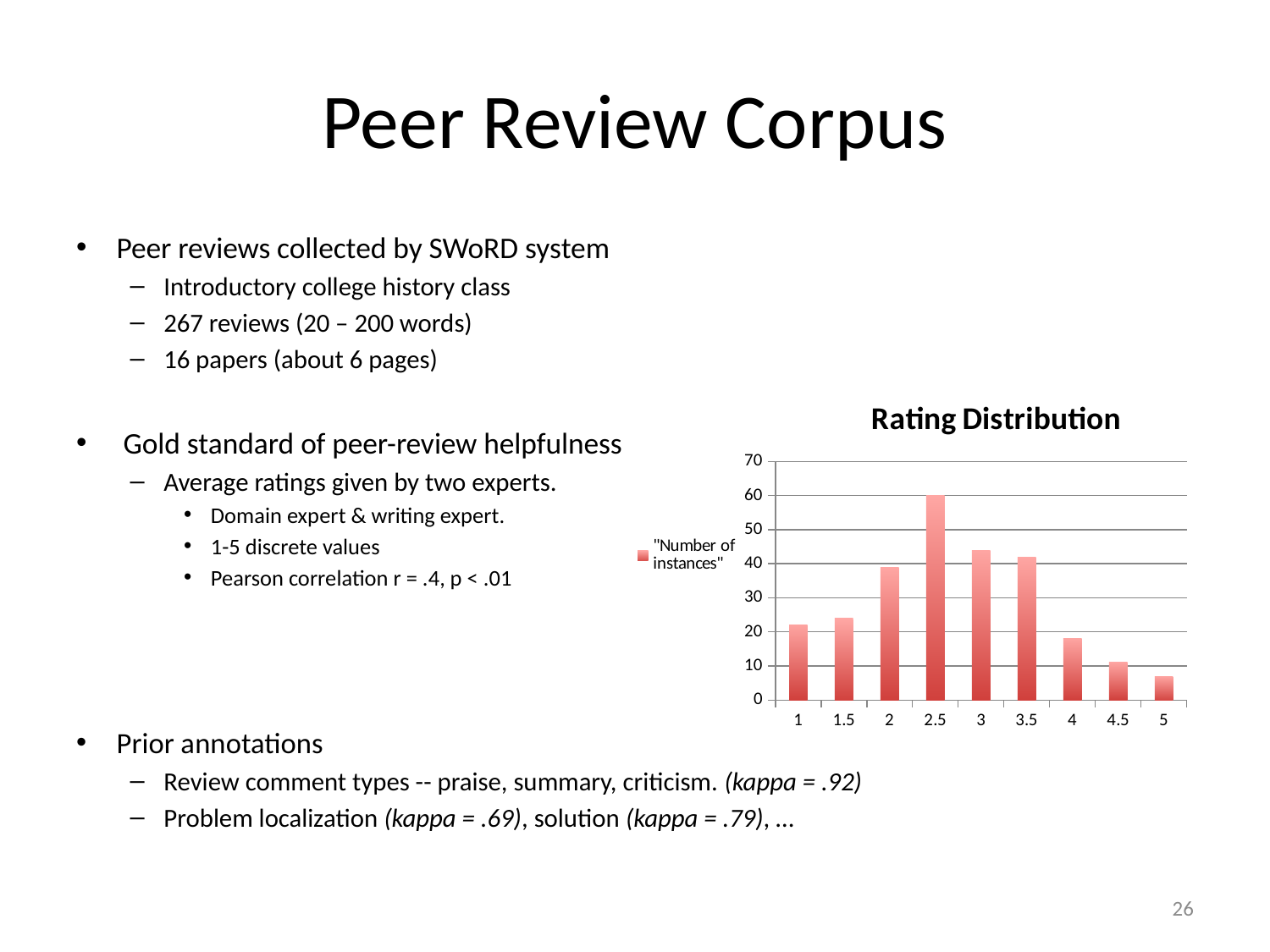
How many rating categories are shown on the x axis of the chart? 9 How many series does the chart legend list? 1 What is the legend entry for the series in the chart? "Number of instances" Which rating has the highest number of instances? 2.5 Is the number of instances for rating 2 greater or less than 30? greater Is the number of instances for rating 1 greater or less than 30? less Which rating has the lowest number of instances? 5 Which rating has more instances, 2 or 4? 2 Is the number of instances for rating 5 greater or less than 10? less What is the number of instances for rating 2.5? 60 What is the title of the chart? Rating Distribution What type of chart is shown on the slide? bar chart